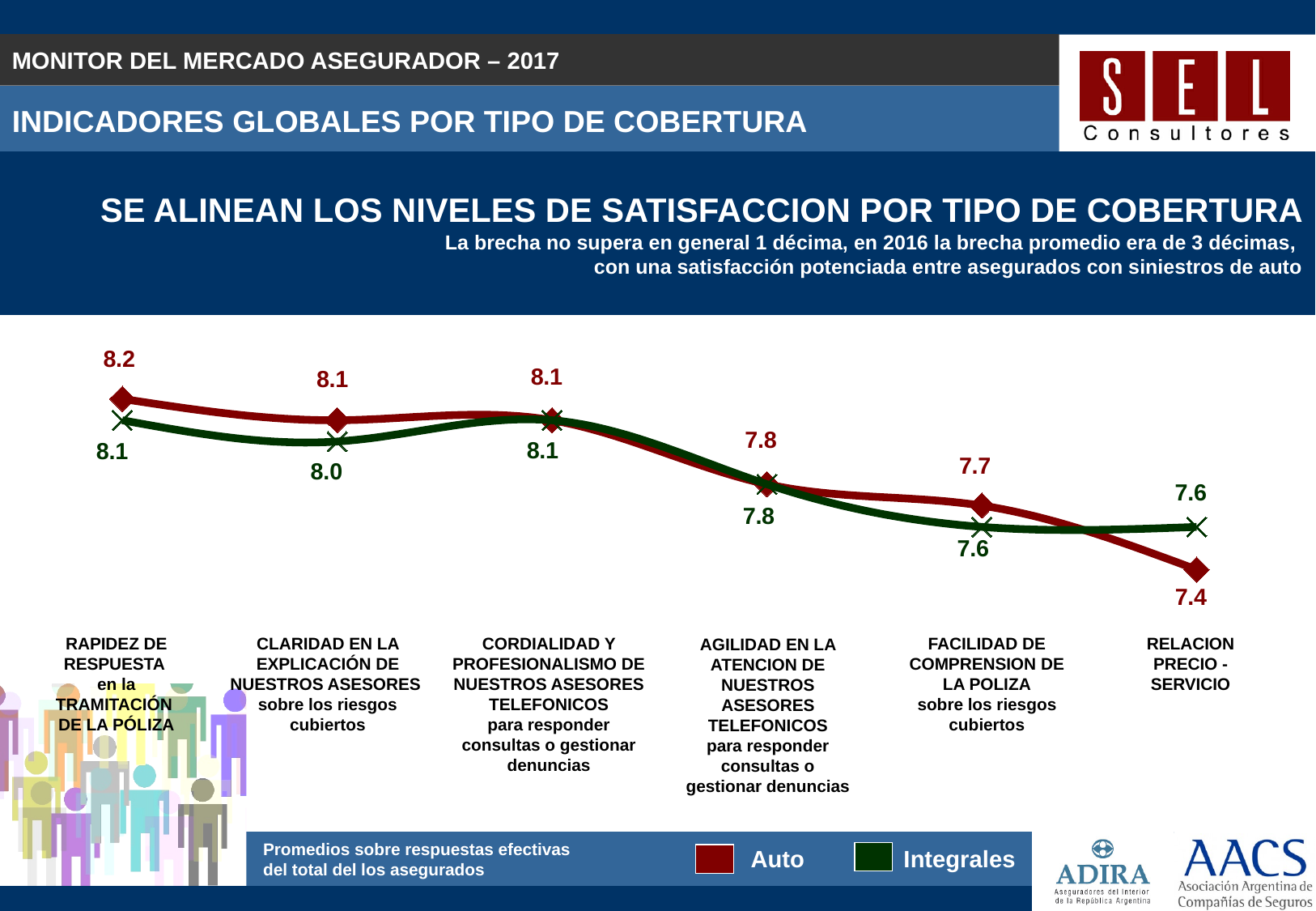
Which category has the highest Auto value? RAPIDEZ DE RESPUESTA en la TRAMITACIÓN DE LA PÓLIZA What is the difference between the Auto and Integrales values for RELACION PRECIO - SERVICIO? 0.2 What is the Integrales value for CLARIDAD EN LA EXPLICACIÓN DE NUESTROS ASESORES sobre los riesgos cubiertos? 8.0 Do the Auto values generally rise or fall from left to right across the categories? Fall For FACILIDAD DE COMPRENSION DE LA POLIZA, which series has the larger value, Auto or Integrales? Auto How many categories are shown on the x axis? 6 Which category has the lowest Auto value? RELACION PRECIO - SERVICIO What is the Auto value for RELACION PRECIO - SERVICIO? 7.4 What kind of chart is shown on the slide? Line chart How many series does the legend list? 2 What is the Auto value for RAPIDEZ DE RESPUESTA en la TRAMITACIÓN DE LA PÓLIZA? 8.2 What is the Integrales value for FACILIDAD DE COMPRENSION DE LA POLIZA? 7.6